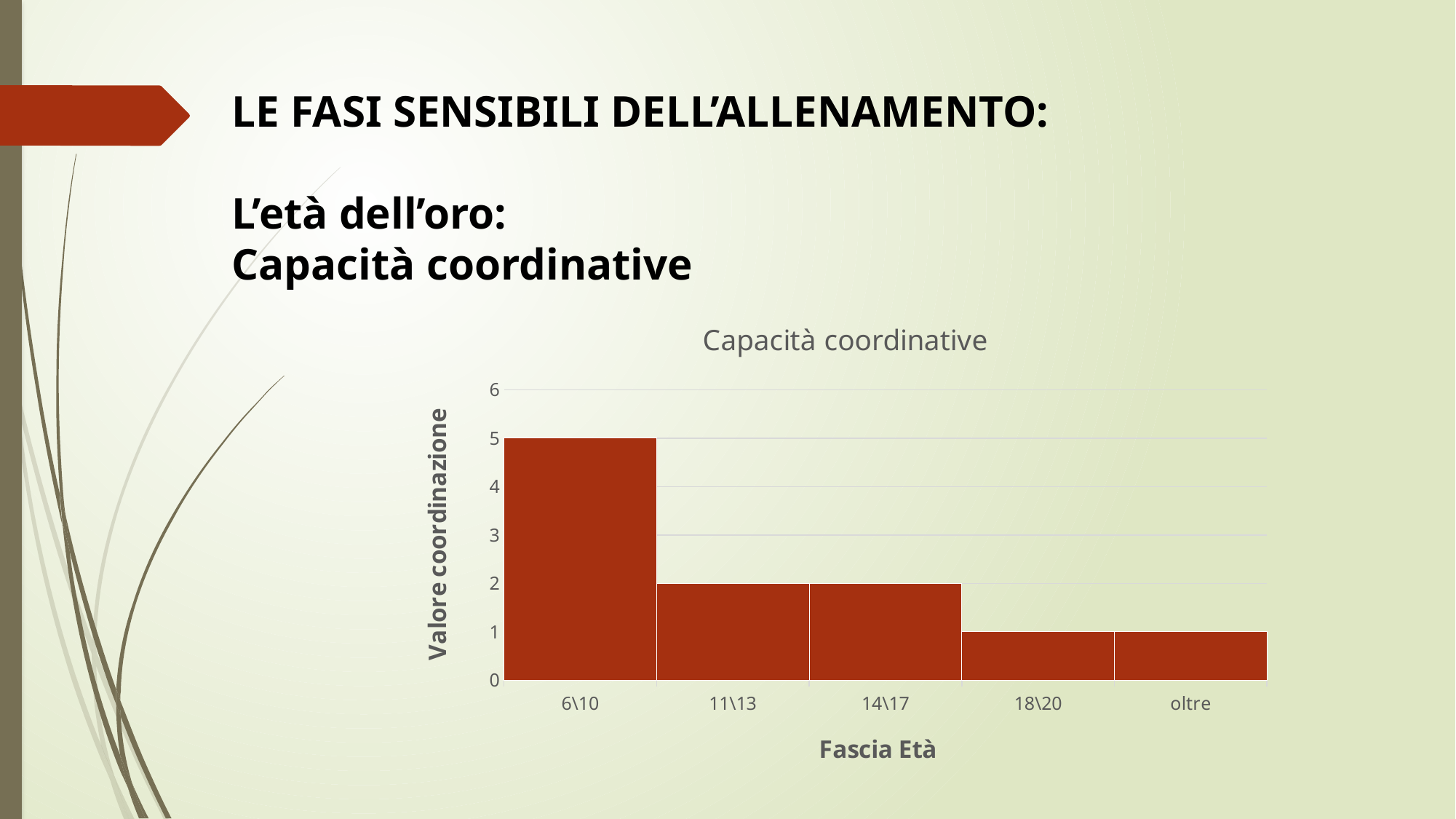
What is the value for the 6\10 age group? 5 Which age group has the highest value? 6\10 What is the value for the 'oltre' category? 1 Do the values generally rise or fall from left to right along the x axis? fall Which is larger, the value for 11\13 or the value for 18\20? 11\13 What is the label of the x axis of the chart? Fascia Età What is the difference between the value for 6\10 and the value for 14\17? 3 What is the value for the 18\20 age group? 1 What is the title of the chart? Capacità coordinative What is the value for the 11\13 age group? 2 How many age categories are shown on the x axis? 5 What type of chart is shown on the slide? bar chart